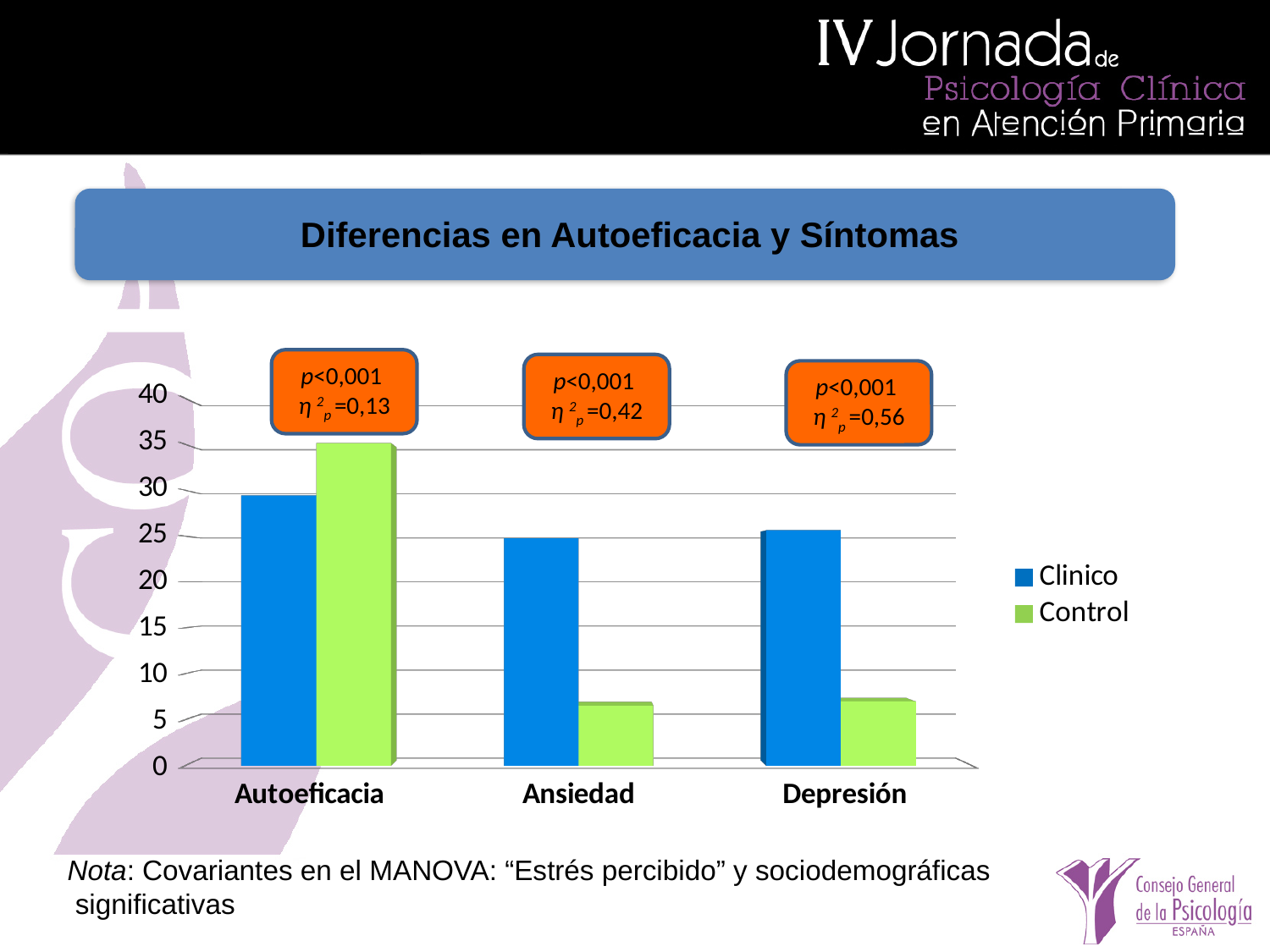
How many series does the chart legend list? 2 Which series has the higher value for Depresión, Clinico or Control? Clinico Which series has the higher value for Autoeficacia, Clinico or Control? Control What is the title shown above the chart? Diferencias en Autoeficacia y Síntomas What kind of chart is shown on the slide? bar chart For the Control series, which category has the highest value? Autoeficacia Is the Control value for Ansiedad greater or less than 10? less Is the Control value for Autoeficacia greater or less than 30? greater Is the Clinico value for Depresión greater or less than 20? greater For the Clinico series, which category has the highest value? Autoeficacia Which series has the higher value for Ansiedad, Clinico or Control? Clinico How many categories are shown on the x axis of the chart? 3